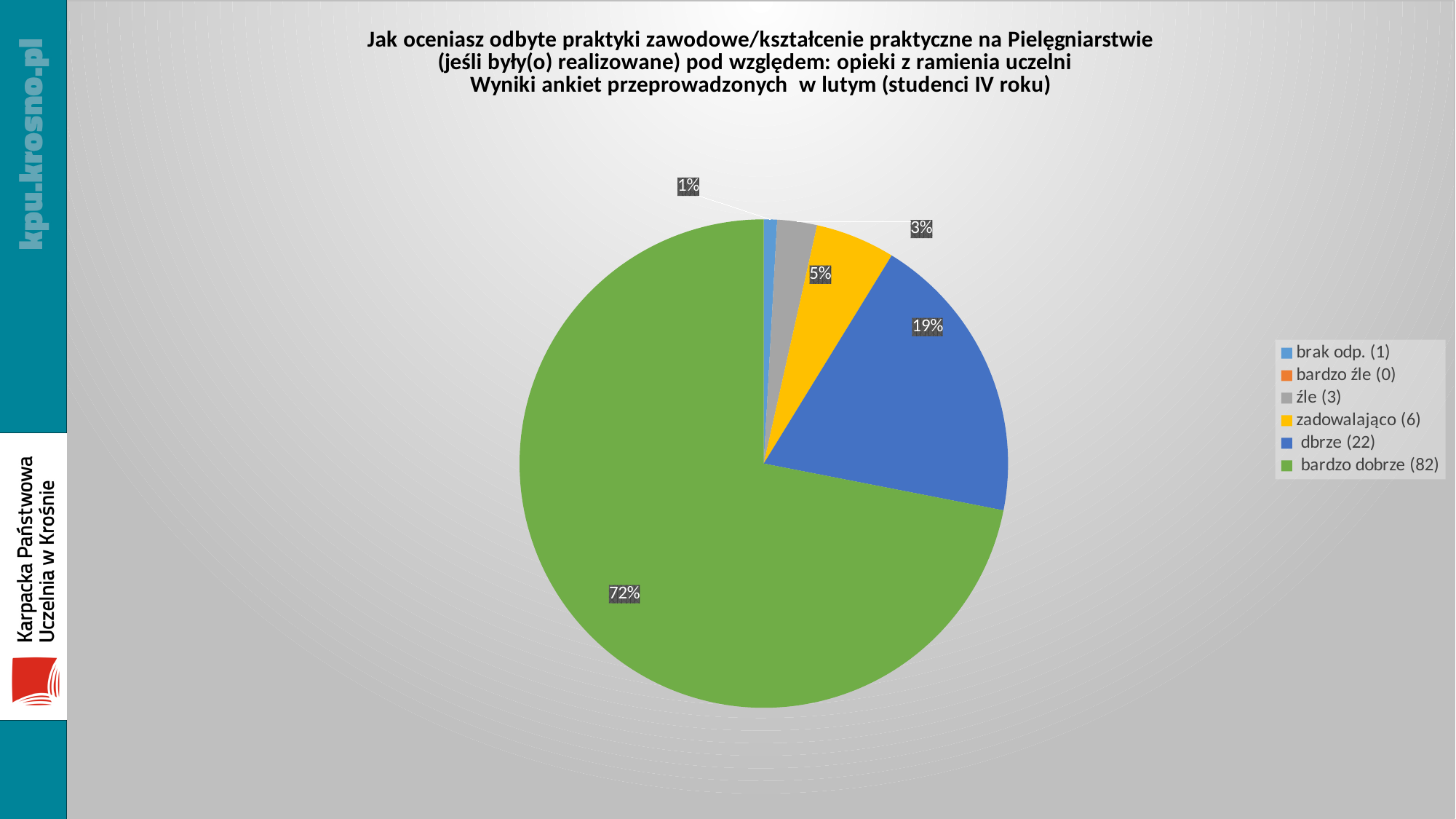
What percentage share does the 'zadowalająco' slice have? 5% How many responses does the legend show for 'dbrze'? 22 What percentage share does the 'źle' slice have? 3% How many entries does the legend list? 6 What percentage share does the 'dbrze' slice have? 19% Which colour represents 'zadowalająco' in the pie chart? yellow Which category has the largest slice of the pie? bardzo dobrze What is the difference in percentage points between the 'bardzo dobrze' and 'dbrze' slices? 53 How many responses does the legend show for 'bardzo źle'? 0 What kind of chart is shown on the slide? pie chart